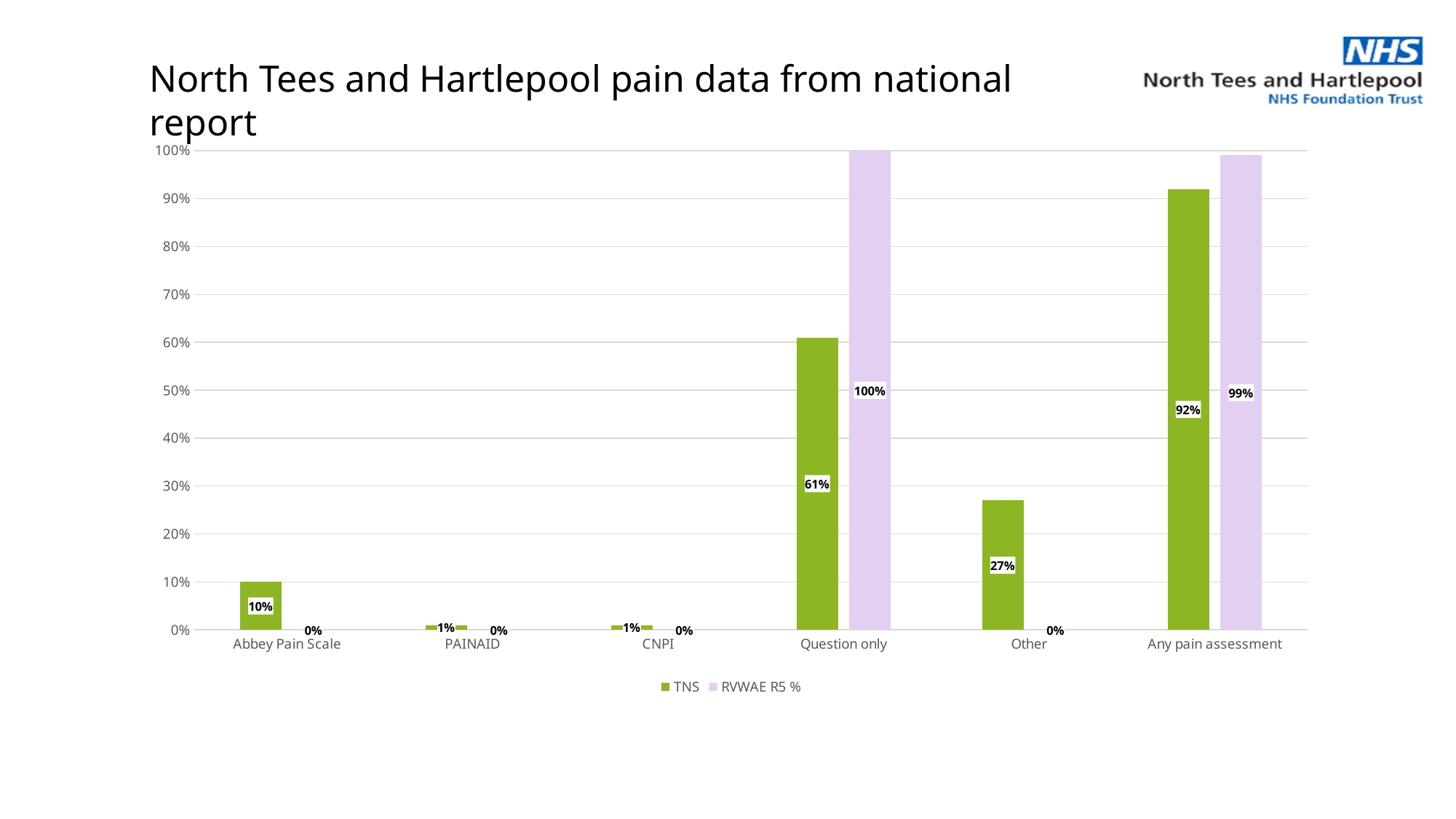
What is the RVWAE R5 % value for Any pain assessment? 99% Which category has the highest TNS value? Any pain assessment Is the TNS value for Other greater or less than 20%? greater How many categories are shown on the x axis? 6 What is the TNS value for Abbey Pain Scale? 10% What is the TNS value for Question only? 61% Which category has the highest RVWAE R5 % value? Question only Which is larger for Any pain assessment, the TNS value or the RVWAE R5 % value? RVWAE R5 % How many series does the legend list? 2 What kind of chart is shown on the slide? Bar chart What is the difference between the RVWAE R5 % value and the TNS value for Question only? 39% What is the RVWAE R5 % value for Other? 0%